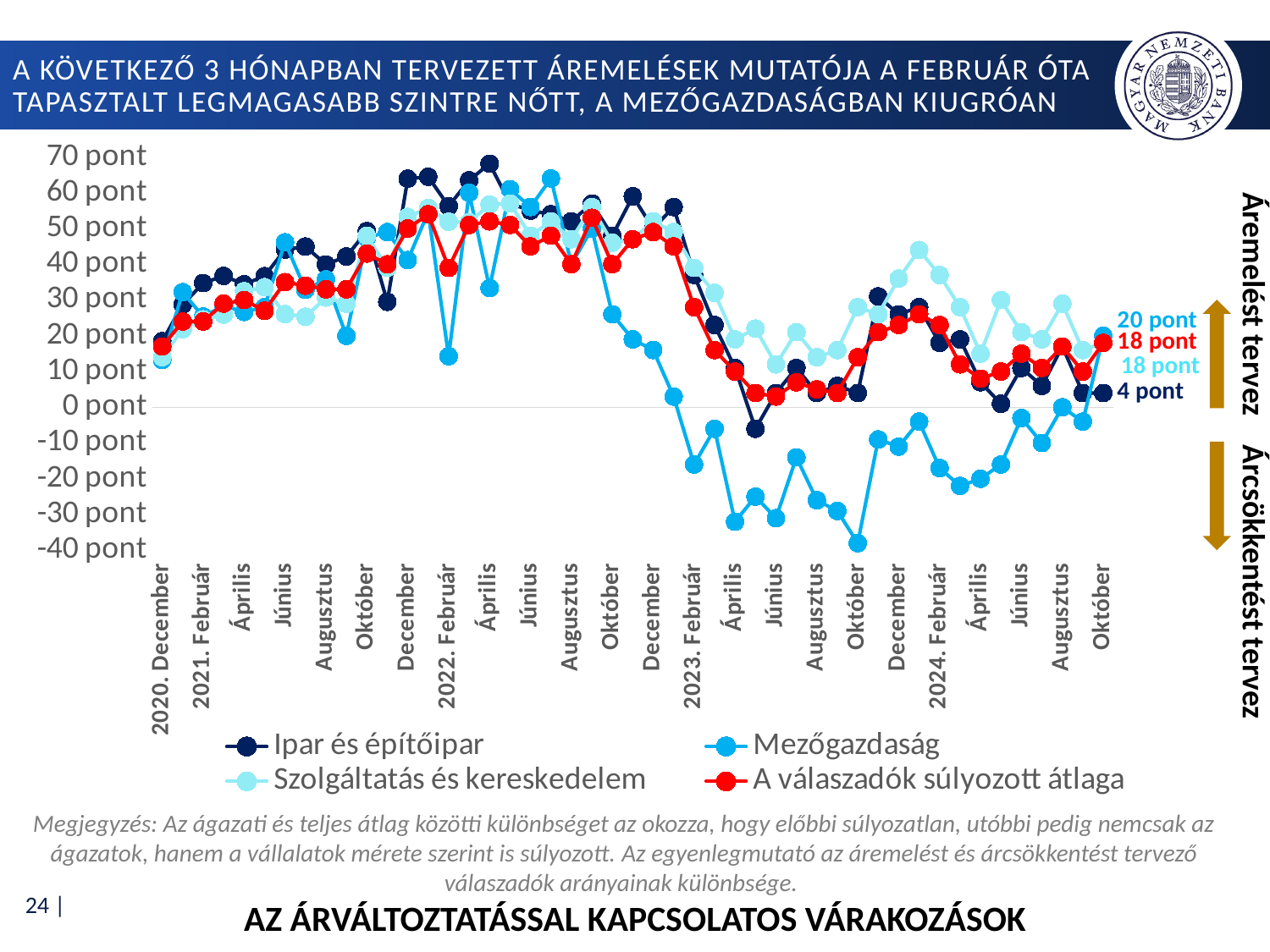
What is the difference between the latest values of Mezőgazdaság and Ipar és építőipar? 16 pont At the end of the chart, which is larger: the value for Mezőgazdaság or for Ipar és építőipar? Mezőgazdaság How many series does the legend list? 4 What kind of chart is shown on the slide? Line chart What is the latest value shown for A válaszadók súlyozott átlaga? 18 pont Which series has the highest value at the end of the chart (2024 October)? Mezőgazdaság What is the latest value shown for the Mezőgazdaság series? 20 pont Which series has the lowest value at the end of the chart (2024 October)? Ipar és építőipar What is the latest value shown for the Szolgáltatás és kereskedelem series? 18 pont Is the value for Ipar és építőipar in 2022 April greater or less than 60 pont? greater What is the latest value shown for the Ipar és építőipar series? 4 pont Is the value for Mezőgazdaság in 2023 October greater or less than -30 pont? less